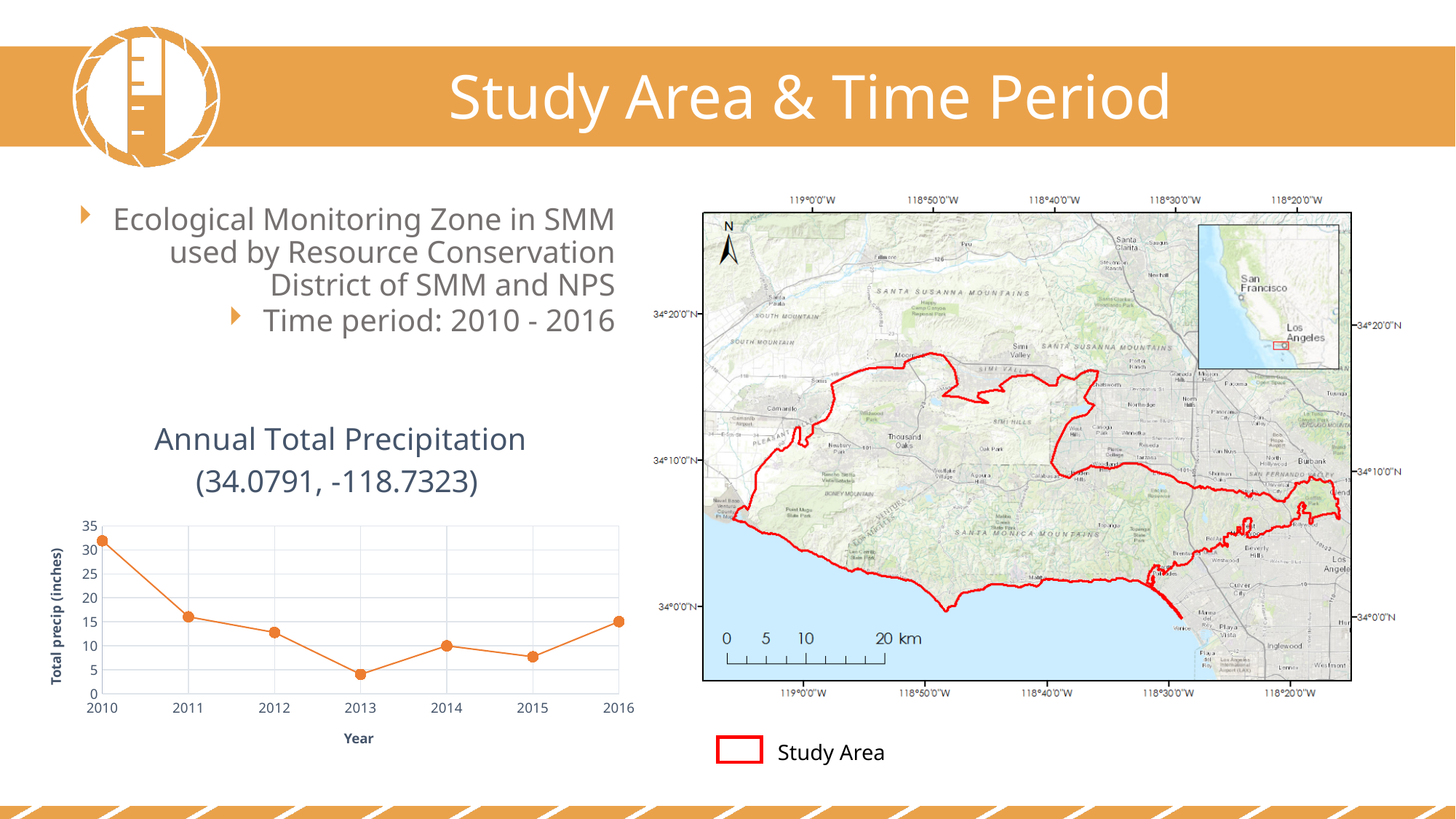
Is the total precipitation for 2011 greater or less than 15 inches? greater Does total precipitation rise or fall from 2010 to 2013? fall Which year has higher total precipitation, 2014 or 2015? 2014 What kind of chart is the Annual Total Precipitation chart? line chart Which year has the lowest total precipitation in the Annual Total Precipitation chart? 2013 Is the total precipitation for 2015 greater or less than 10 inches? less Is the total precipitation for 2010 greater or less than 30 inches? greater Which year has the highest total precipitation in the Annual Total Precipitation chart? 2010 How many years are plotted in the Annual Total Precipitation chart? 7 What is the label of the y axis in the Annual Total Precipitation chart? Total precip (inches) Which year has higher total precipitation, 2010 or 2011? 2010